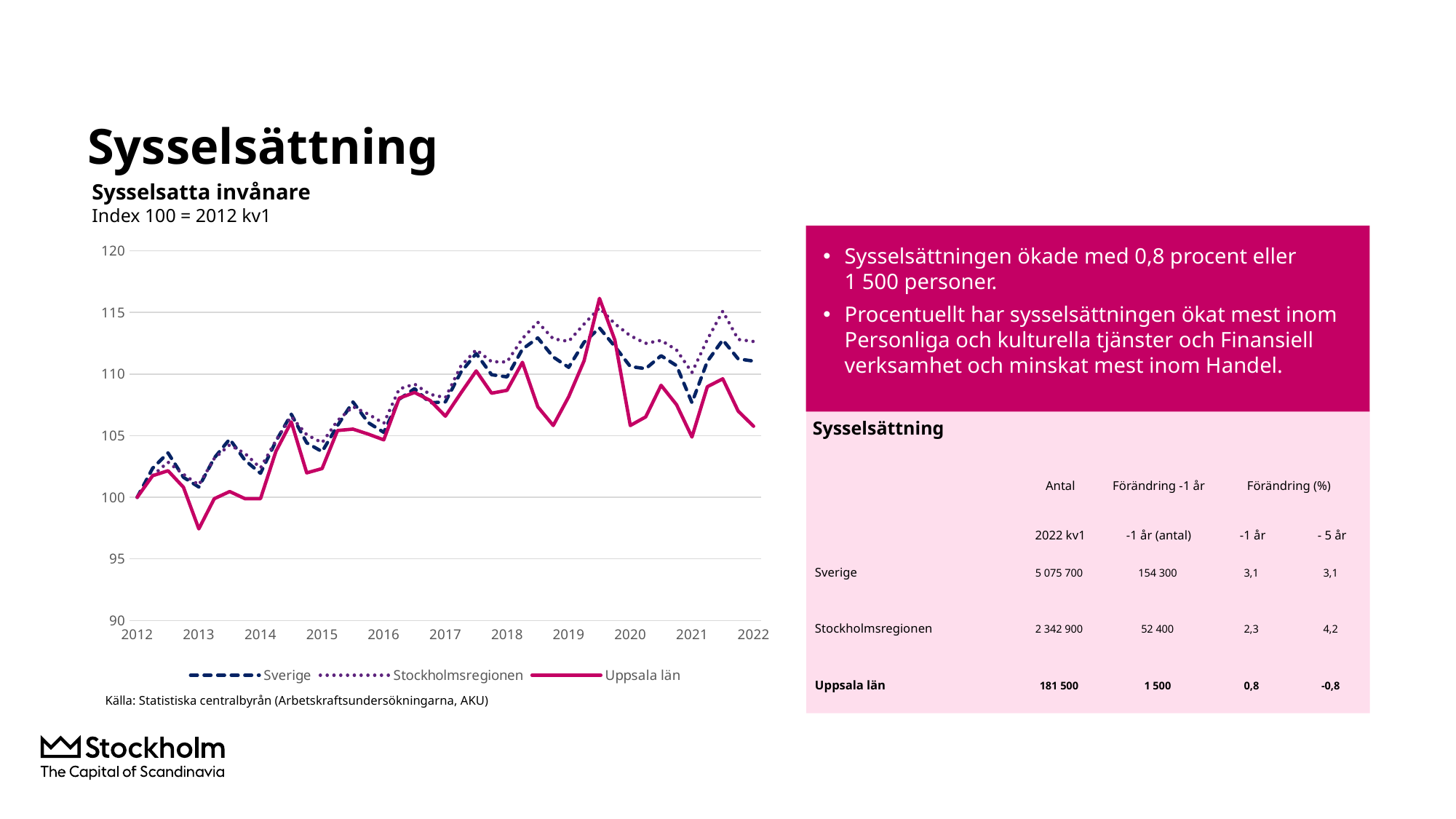
Is the value for Uppsala län at 2022 greater or less than 110? less Is the value for Uppsala län at its lowest point in 2013 greater or less than 100? less At 2022, which series has the lowest value? Uppsala län How many series does the chart legend list? 3 Which series are listed in the chart legend? Sverige, Stockholmsregionen, Uppsala län At 2022, which is higher: Stockholmsregionen or Uppsala län? Stockholmsregionen Overall, do the index values rise or fall from 2012 to 2022? rise What is the index value for all three series at 2012 kv1? 100 What kind of chart is shown on the slide? line chart What is the title of the chart? Sysselsatta invånare Is the value for Uppsala län at its peak in 2019 greater or less than 115? greater